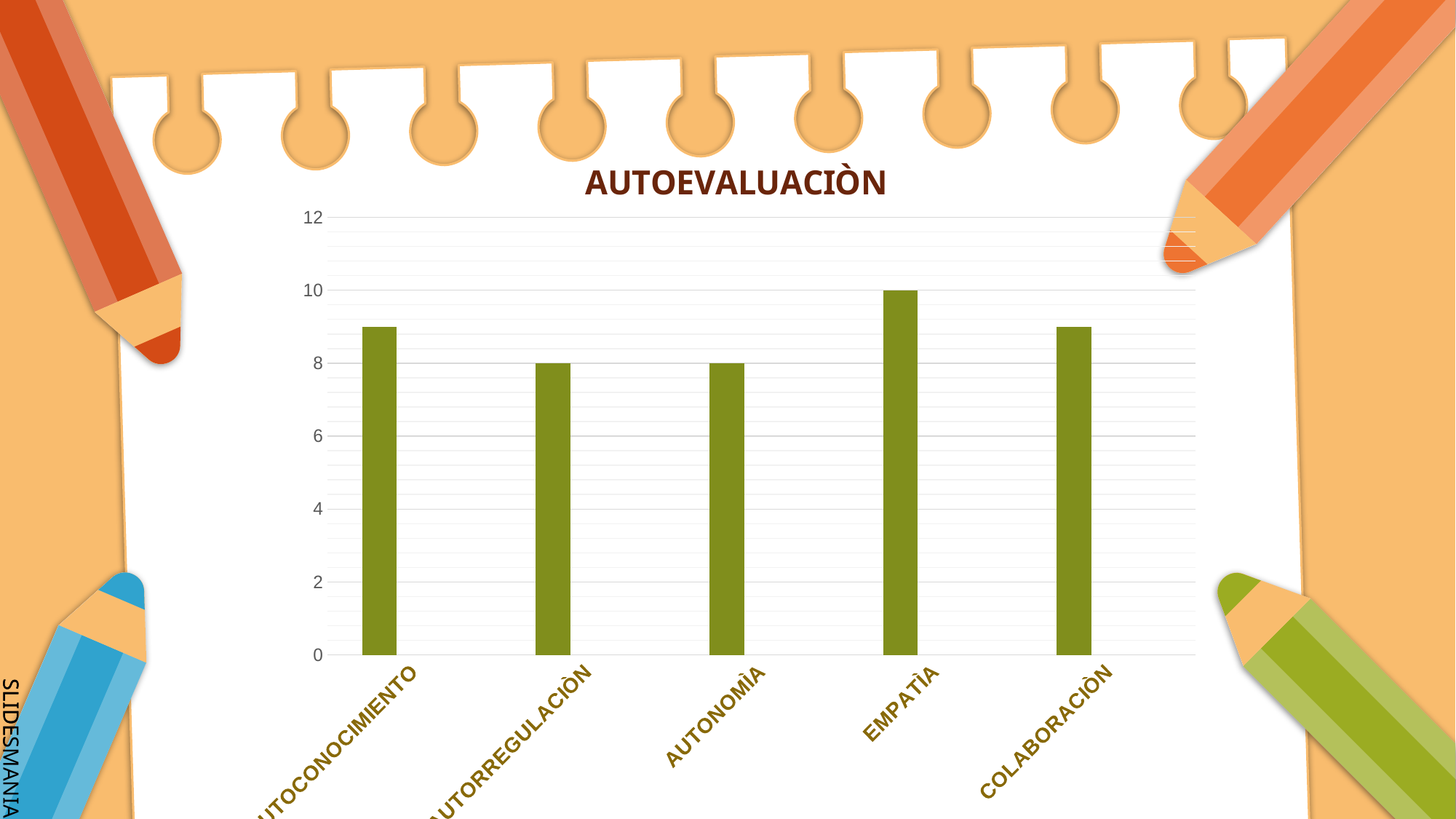
How many categories are plotted in the chart? 5 What is the title of the chart? AUTOEVALUACIÒN Which category has the highest value? EMPATÌA What colour are the bars in the chart? green What is the value for AUTORREGULACIÒN? 8 Which is larger, the value for COLABORACIÒN or the value for AUTONOMÌA? COLABORACIÒN What is the value for AUTONOMÌA? 8 What kind of chart is shown on the slide? bar chart What is the value for EMPATÌA? 10 Is the value for COLABORACIÒN greater or less than 8? greater Is the value for AUTOCONOCIMIENTO greater or less than 10? less What is the difference between the values for EMPATÌA and AUTONOMÌA? 2